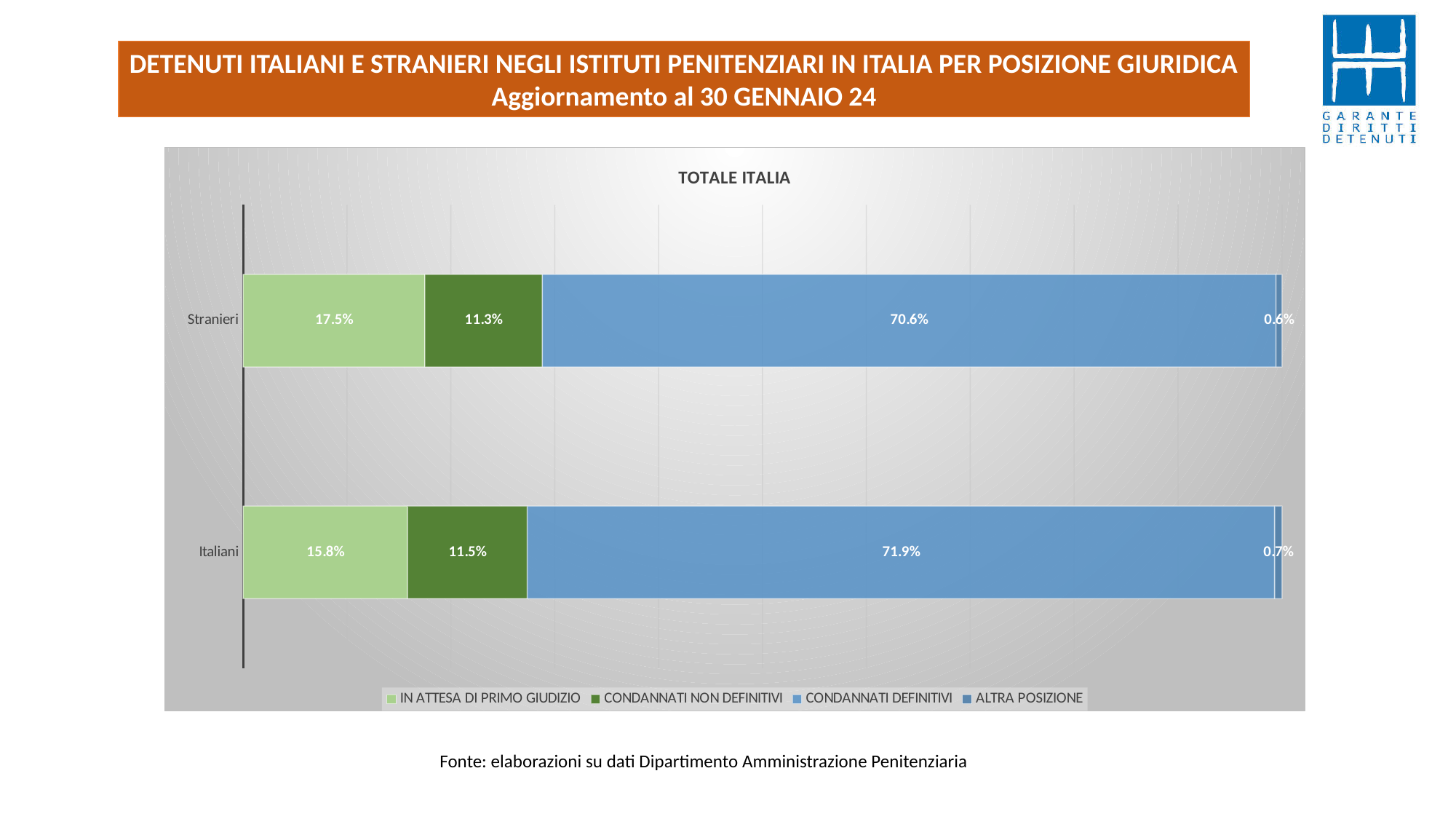
What is the difference between the IN ATTESA DI PRIMO GIUDIZIO values for Stranieri and Italiani? 1.7% What is the value of ALTRA POSIZIONE for Stranieri? 0.6% What is the title of the chart? TOTALE ITALIA What is the value of CONDANNATI NON DEFINITIVI for Italiani? 11.5% What is the value of IN ATTESA DI PRIMO GIUDIZIO for Stranieri? 17.5% What is the value of CONDANNATI DEFINITIVI for Italiani? 71.9% How many series does the legend list? 4 What kind of chart is shown on the slide? Stacked bar chart Which series has the smallest share in the Italiani bar? ALTRA POSIZIONE How many categories are plotted on the chart? 2 Which category has the higher value for CONDANNATI DEFINITIVI, Stranieri or Italiani? Italiani Which series has the largest share in the Stranieri bar? CONDANNATI DEFINITIVI